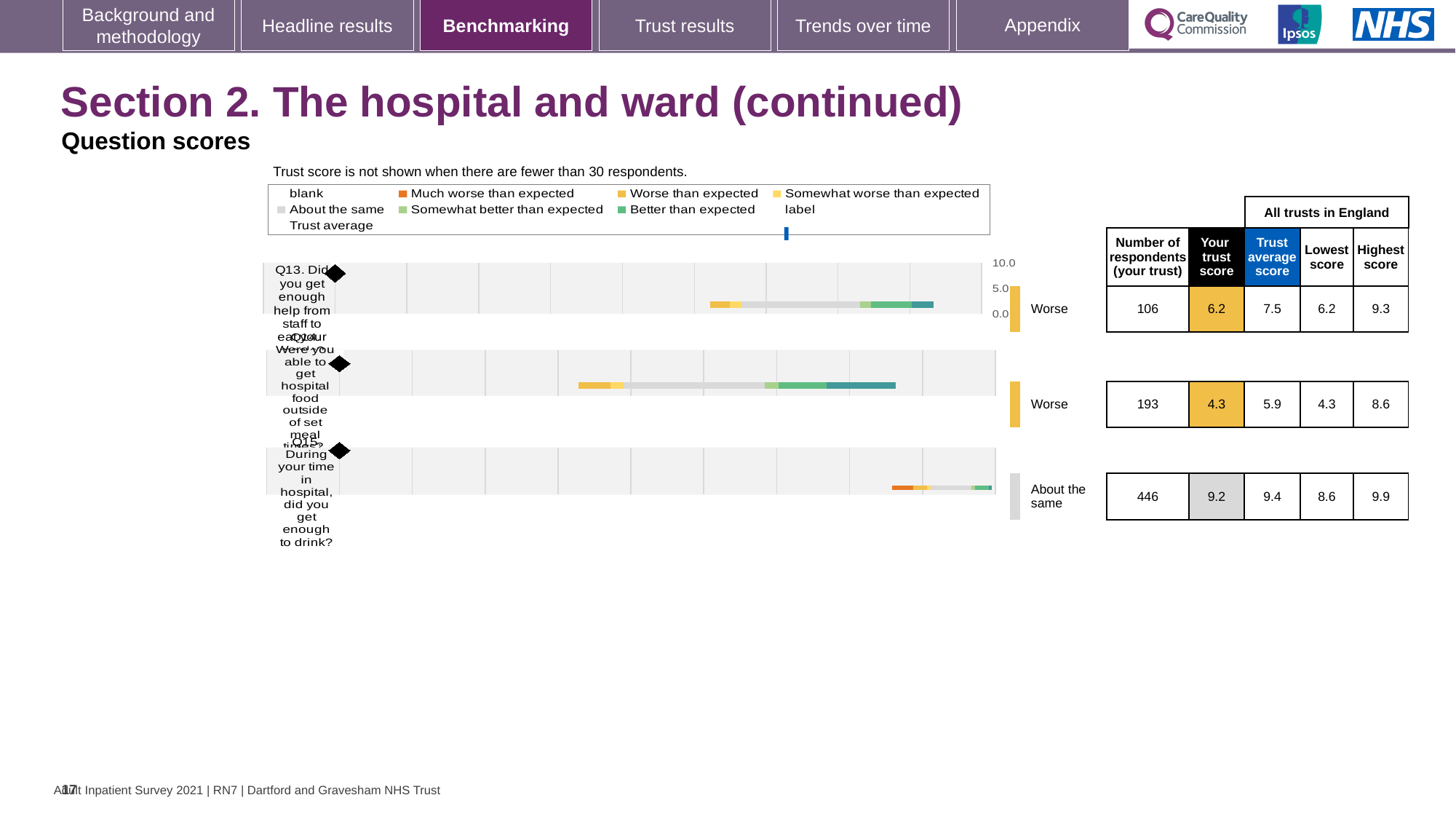
What is the trust average score across all trusts in England for Q14? 5.9 How many questions are plotted on the chart? 3 Which question has the lowest trust score for this trust? Q14 What is the difference between the trust average score and this trust's score for Q13? 1.3 What benchmark category is shown for Q15? About the same Is this trust's score for Q14 greater or less than 5.0? less What is the difference between the highest and lowest scores across all trusts in England for Q15? 1.3 For Q14, which is larger: this trust's score or the trust average score? Trust average score How many respondents answered Q15 (did you get enough to drink?) for this trust? 446 What is the trust score for Q13 (Did you get enough help from staff to eat your meals?)? 6.2 Which question has the highest trust score for this trust? Q15 What is the highest score among all trusts in England for Q14? 8.6